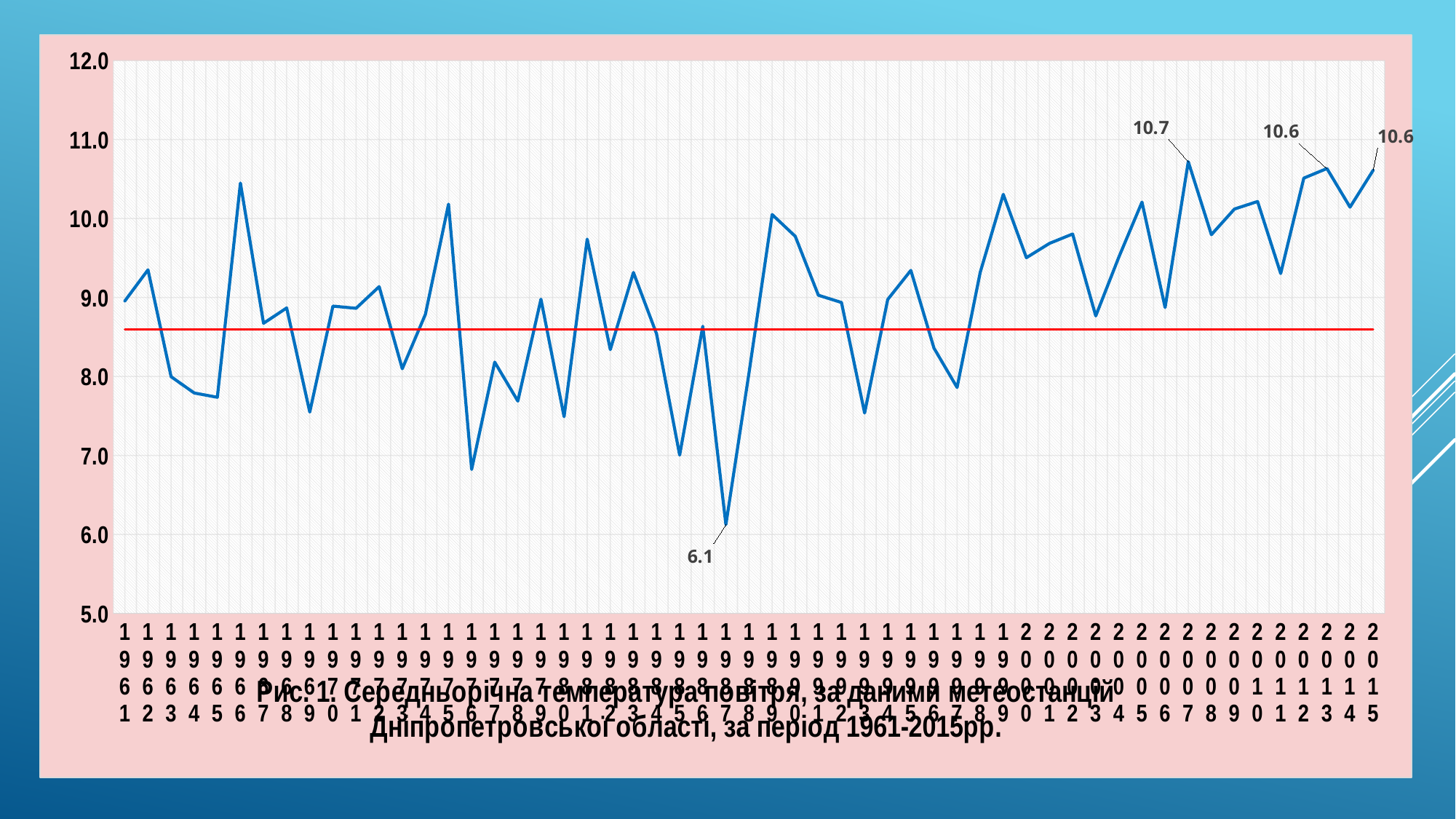
How many years are plotted along the x axis? 55 What is the difference between the labelled values for 2007 and 1987? 4.6 Is the value for 1966 greater or less than 10.0? greater Which year has the lowest average annual temperature on the chart? 1987 What is the labelled temperature value for 2007? 10.7 Is the value for 1970 greater or less than 8.0? greater What is the labelled temperature value for 1987? 6.1 Which year has the highest average annual temperature on the chart? 2007 Which year has the higher value, 1966 or 1970? 1966 What is the labelled temperature value for 2015? 10.6 What kind of chart is shown on the slide? line chart Over the whole period 1961-2015, does the average annual temperature generally rise or fall? rise